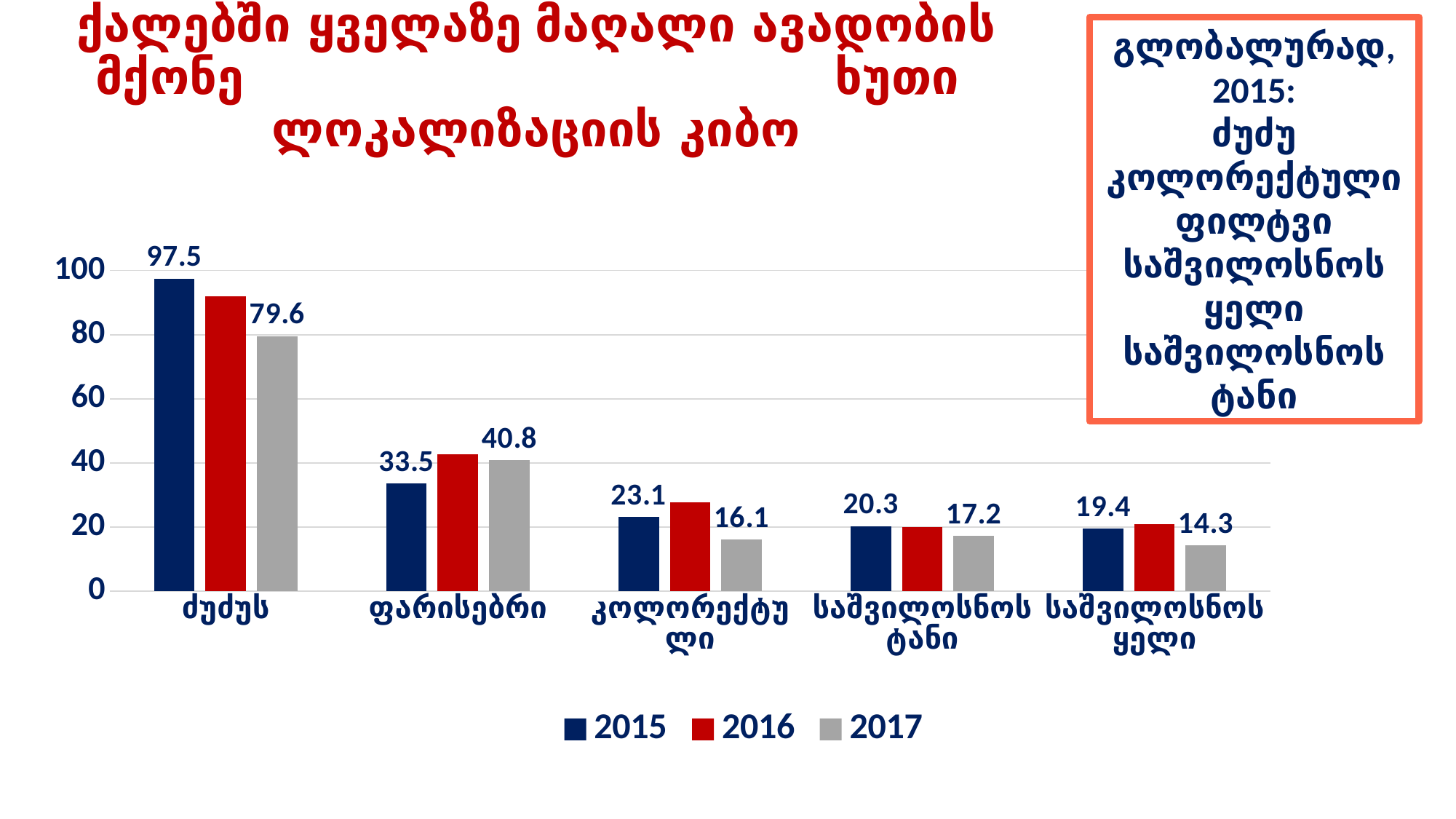
What kind of chart is shown on the slide? bar chart Is the 2016 value for ძუძუს greater or less than 80? greater What is the difference between the 2015 and 2017 values for ძუძუს? 17.9 How many series does the legend list? 3 What is the 2015 value for ძუძუს? 97.5 How many categories are shown on the x axis? 5 Which category has the lowest 2017 value? საშვილოსნოს ყელი What is the 2017 value for საშვილოსნოს ყელი? 14.3 Which is larger for ფარისებრი: the 2015 value or the 2017 value? 2017 What is the 2017 value for ფარისებრი? 40.8 What is the 2015 value for კოლორექტული? 23.1 Which category has the highest 2015 value? ძუძუს